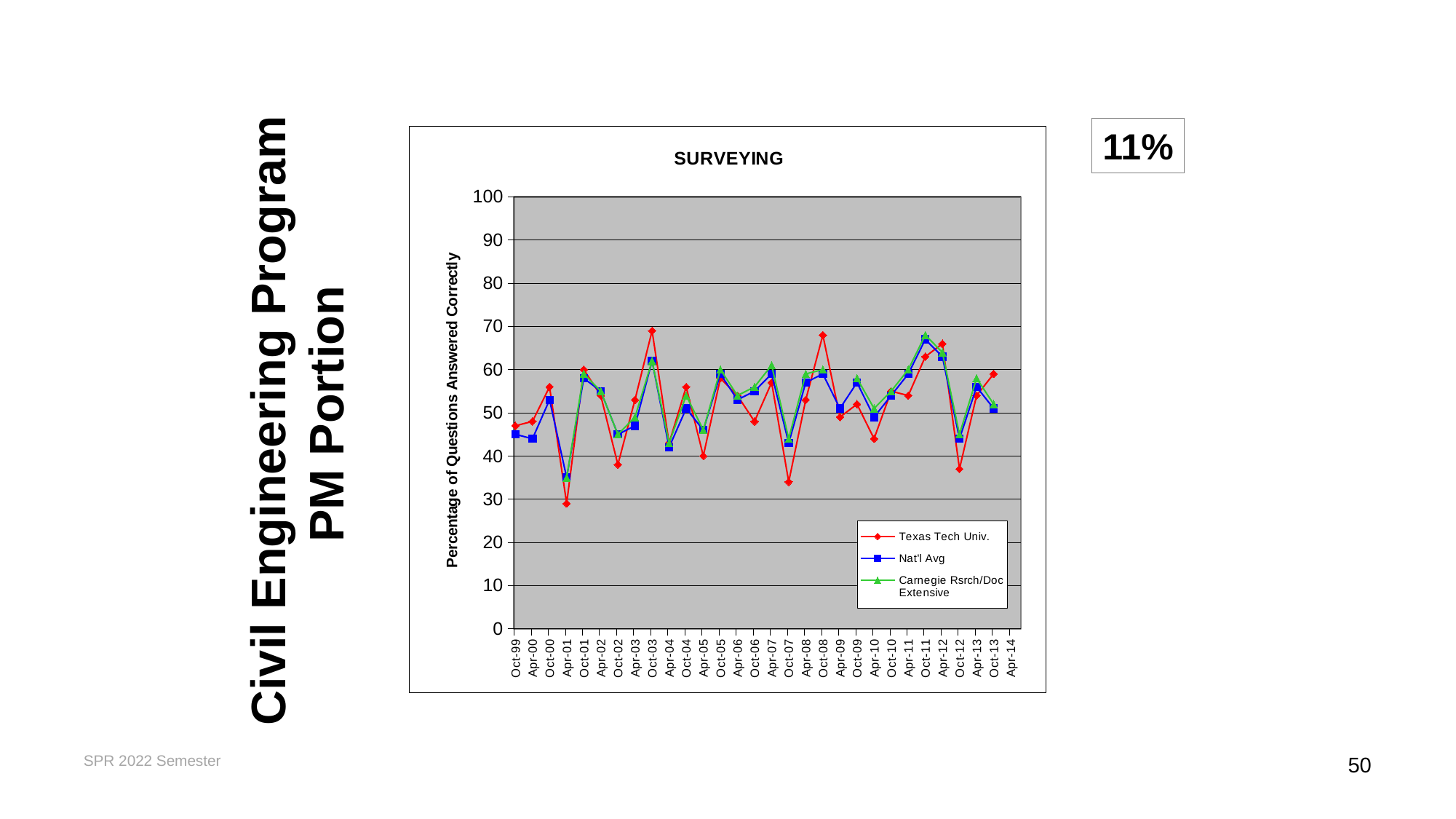
What kind of chart is shown on the slide? Line chart Is the Texas Tech Univ. value for Oct-12 greater or less than 40? less At which date does the Texas Tech Univ. series reach its lowest value? Apr-01 What is the title of the chart? SURVEYING Is the Texas Tech Univ. value for Oct-08 greater or less than 60? greater Is the Nat'l Avg value for Apr-01 greater or less than 40? less At Oct-03, which is larger: the Texas Tech Univ. value or the Nat'l Avg value? Texas Tech Univ. How many series does the legend of the SURVEYING chart list? 3 At Apr-01, which is larger: the Texas Tech Univ. value or the Nat'l Avg value? Nat'l Avg What is the label of the vertical axis? Percentage of Questions Answered Correctly